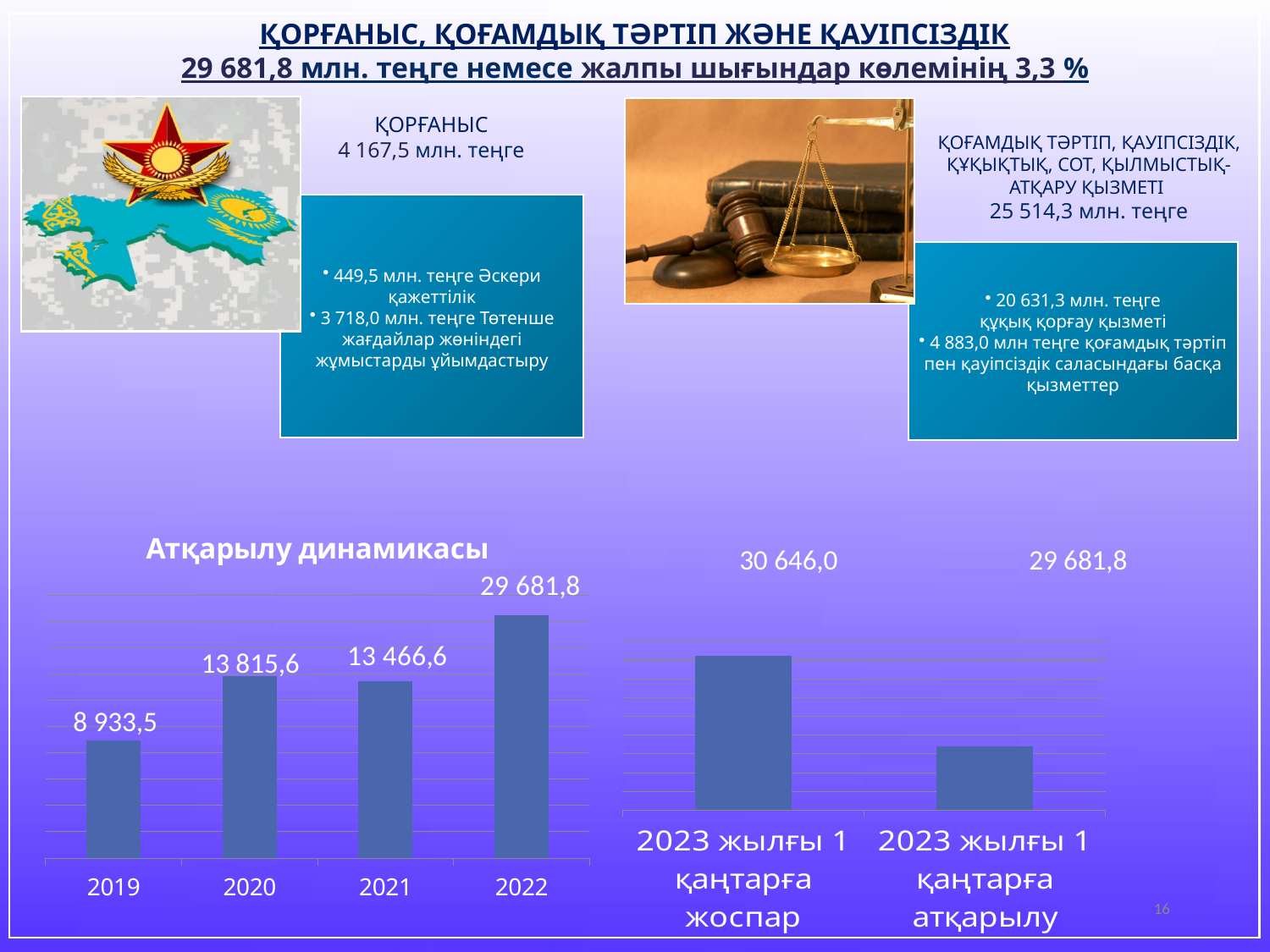
In the chart on the right of the slide, what is the value for '2023 жылғы 1 қаңтарға жоспар'? 30 646,0 What type of chart is the 'Атқарылу динамикасы' chart? Bar chart In the 'Атқарылу динамикасы' chart, which year has the highest value? 2022 How many years are shown in the 'Атқарылу динамикасы' chart? 4 In the 'Атқарылу динамикасы' chart, what is the value for 2019? 8 933,5 In the 'Атқарылу динамикасы' chart, which year has the lowest value? 2019 In the 'Атқарылу динамикасы' chart, which is larger, the value for 2020 or the value for 2021? 2020 In the chart on the right of the slide, what is the value for '2023 жылғы 1 қаңтарға атқарылу'? 29 681,8 In the 'Атқарылу динамикасы' chart, what is the difference between the 2022 value and the 2019 value? 20 748,3 In the 'Атқарылу динамикасы' chart, what is the value for 2021? 13 466,6 In the chart on the right of the slide, what is the difference between the plan (жоспар) and the execution (атқарылу) values? 964,2 In the chart on the right of the slide, which is larger, the plan (жоспар) or the execution (атқарылу)? 2023 жылғы 1 қаңтарға жоспар